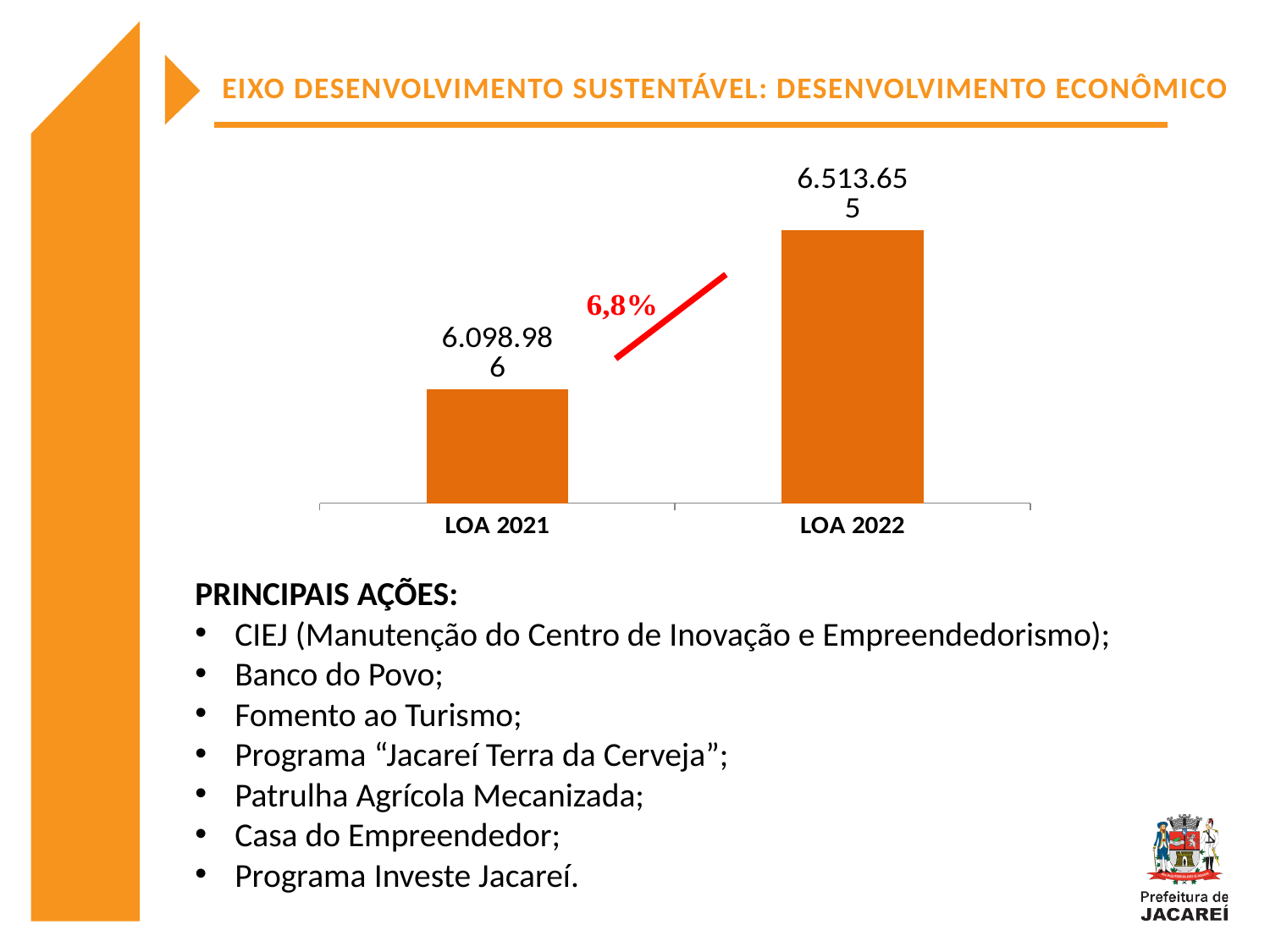
What kind of chart is shown on the slide? Bar chart What is the value for LOA 2021? 6.098.986 What percentage change is annotated between the two bars? 6,8% Which category has the highest value? LOA 2022 What colour are the bars in the chart? Orange Do the values rise or fall from LOA 2021 to LOA 2022? Rise How many categories are shown on the x axis? 2 What is the value for LOA 2022? 6.513.655 Which category has the lowest value? LOA 2021 What is the difference between the values for LOA 2022 and LOA 2021? 414.669 Which is larger, the value for LOA 2021 or the value for LOA 2022? LOA 2022